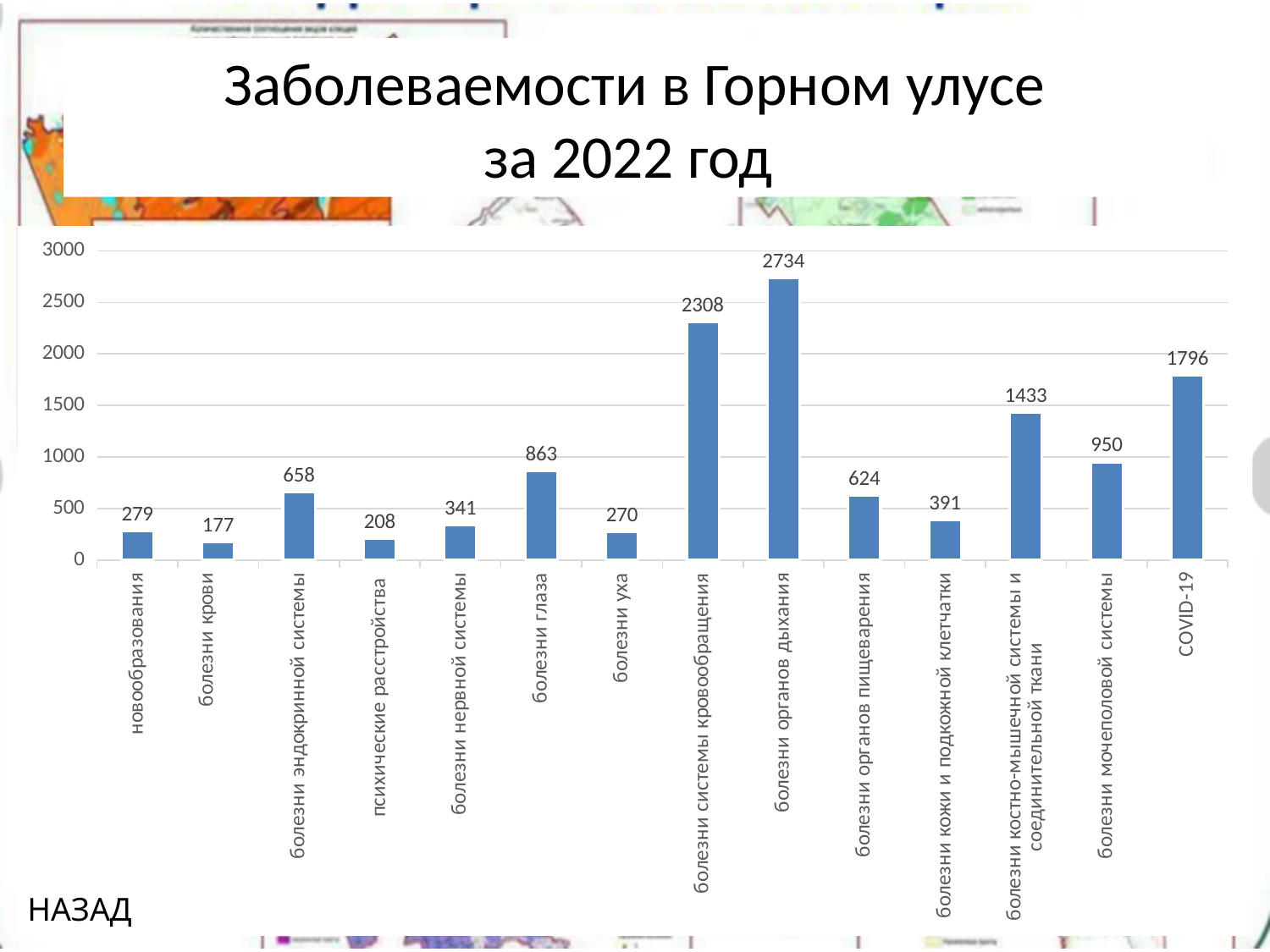
How many categories are shown on the chart? 14 What is the difference between COVID-19 and болезни мочеполовой системы? 846 Which is larger: болезни костно-мышечной системы и соединительной ткани or болезни мочеполовой системы? болезни костно-мышечной системы и соединительной ткани Which category has the lowest value? болезни крови What is the value for болезни органов дыхания? 2734 Which category has the highest value? болезни органов дыхания What is the difference between болезни органов дыхания and болезни системы кровообращения? 426 What kind of chart is shown on the slide? bar chart What is the value for болезни глаза? 863 What is the value for COVID-19? 1796 Is the value for болезни эндокринной системы greater or less than 500? greater What is the title of the slide? Заболеваемости в Горном улусе за 2022 год